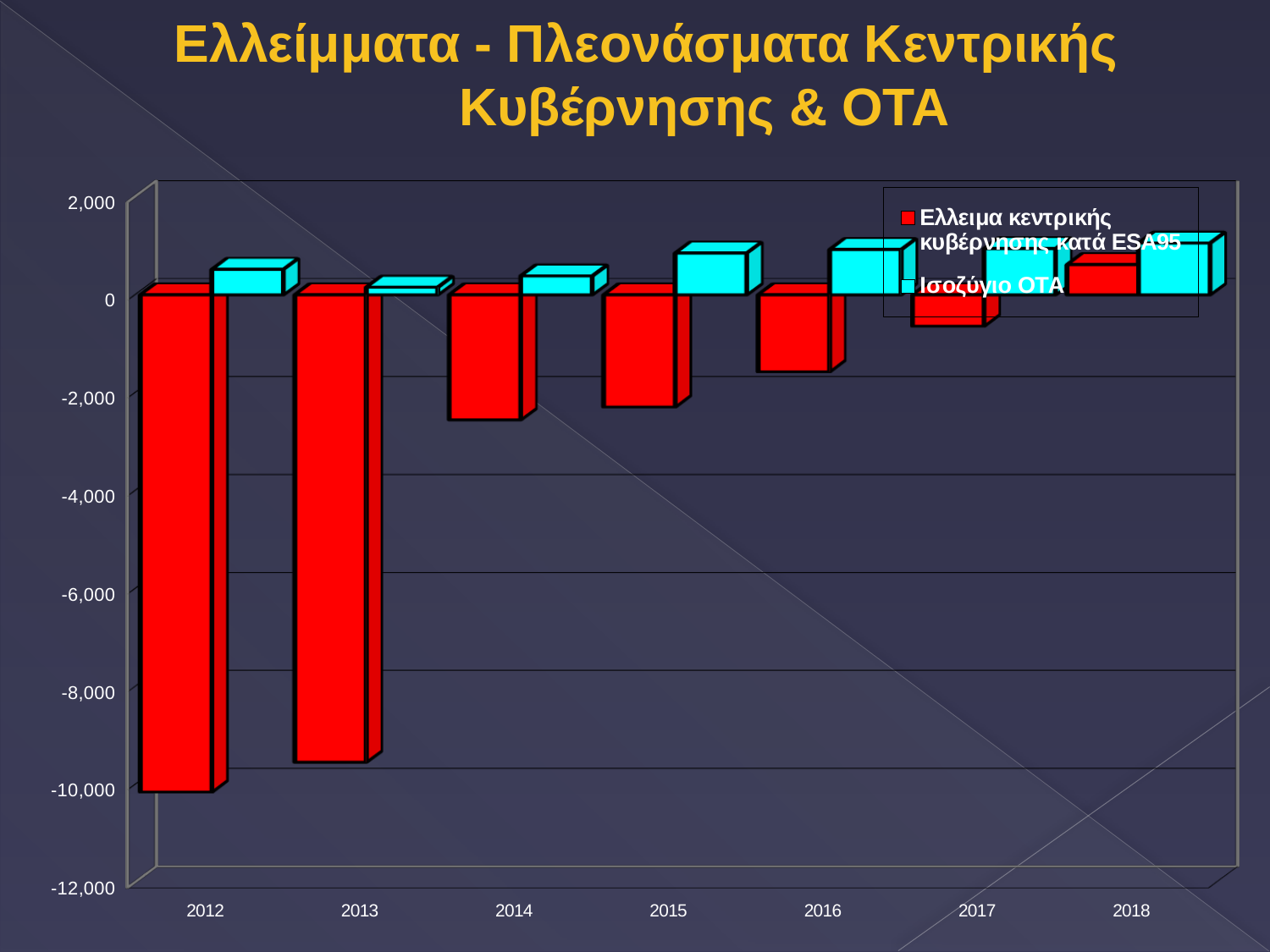
Is the value for Έλλειμα κεντρικής κυβέρνησης κατά ESA95 in 2016 greater or less than -2,000? greater Is the value for Έλλειμα κεντρικής κυβέρνησης κατά ESA95 in 2014 greater or less than -2,000? less How many series does the legend list? 2 Is the value for Έλλειμα κεντρικής κυβέρνησης κατά ESA95 in 2013 greater or less than -8,000? less Which series is drawn in red? Έλλειμα κεντρικής κυβέρνησης κατά ESA95 Which series is drawn in cyan? Ισοζύγιο ΟΤΑ In which year is the value for Έλλειμα κεντρικής κυβέρνησης κατά ESA95 lowest? 2012 What kind of chart is shown on the slide? Bar chart How many years are shown on the x axis? 7 Which is larger, the Έλλειμα κεντρικής κυβέρνησης κατά ESA95 value for 2014 or for 2016? 2016 Which is larger, the Έλλειμα κεντρικής κυβέρνησης κατά ESA95 value for 2012 or for 2013? 2013 Do the values for Έλλειμα κεντρικής κυβέρνησης κατά ESA95 generally rise or fall from 2012 to 2018? rise